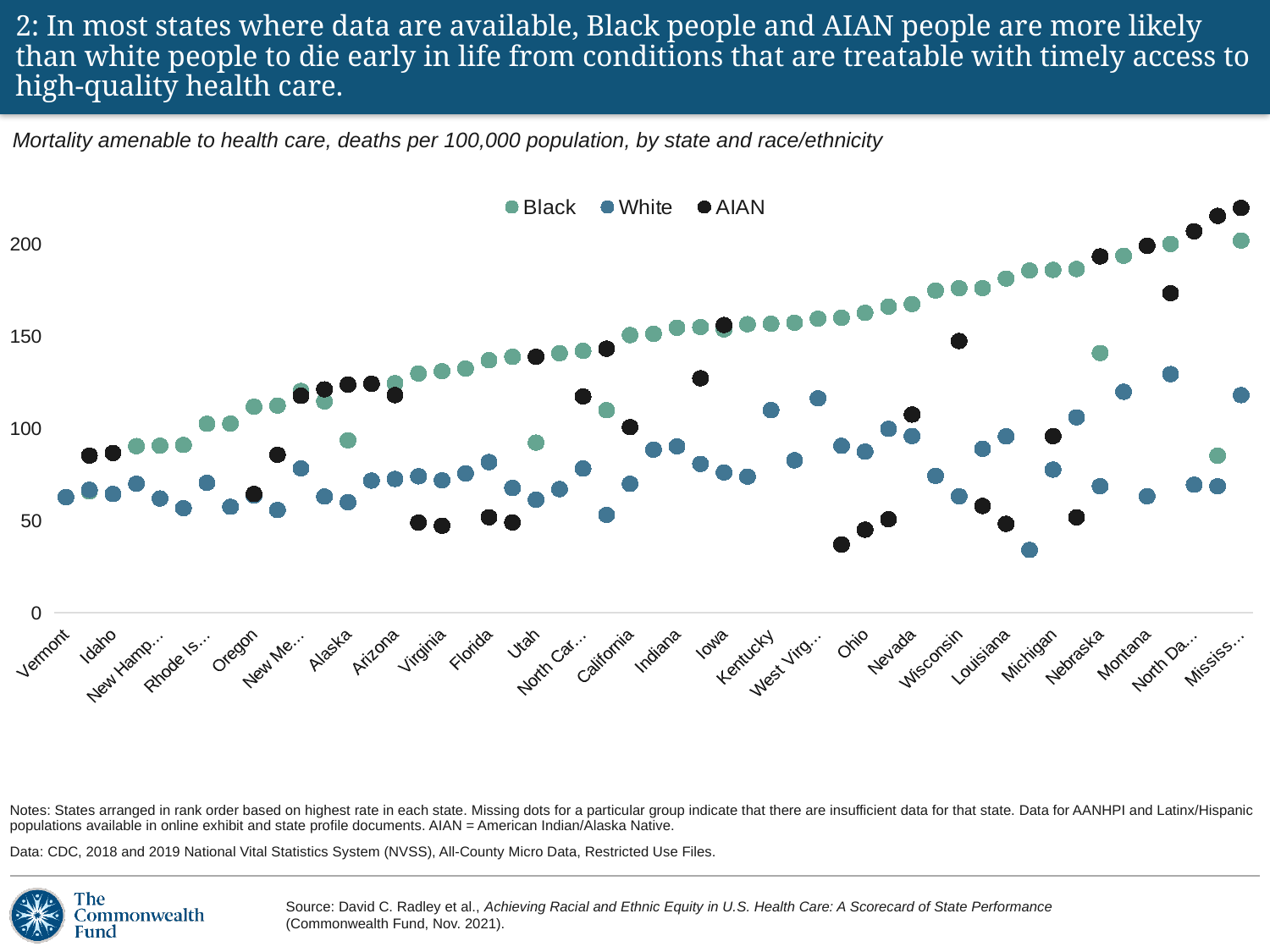
Do the values for the Black series rise or fall moving from left to right across the states? Rise Is the Black value for Mississippi greater or less than 150? greater How many series does the legend list? 3 Which three groups are listed in the chart legend? Black, White, AIAN Which state is the first (leftmost) category on the horizontal axis? Vermont What is the highest value shown on the vertical axis? 200 What kind of chart is shown on the slide? Dot (scatter) chart Is the White value for Mississippi greater or less than 150? less Is the AIAN value for Mississippi greater or less than 200? greater Which series contains the single highest dot on the chart? AIAN What is the chart's subtitle describing the measure plotted? Mortality amenable to health care, deaths per 100,000 population, by state and race/ethnicity